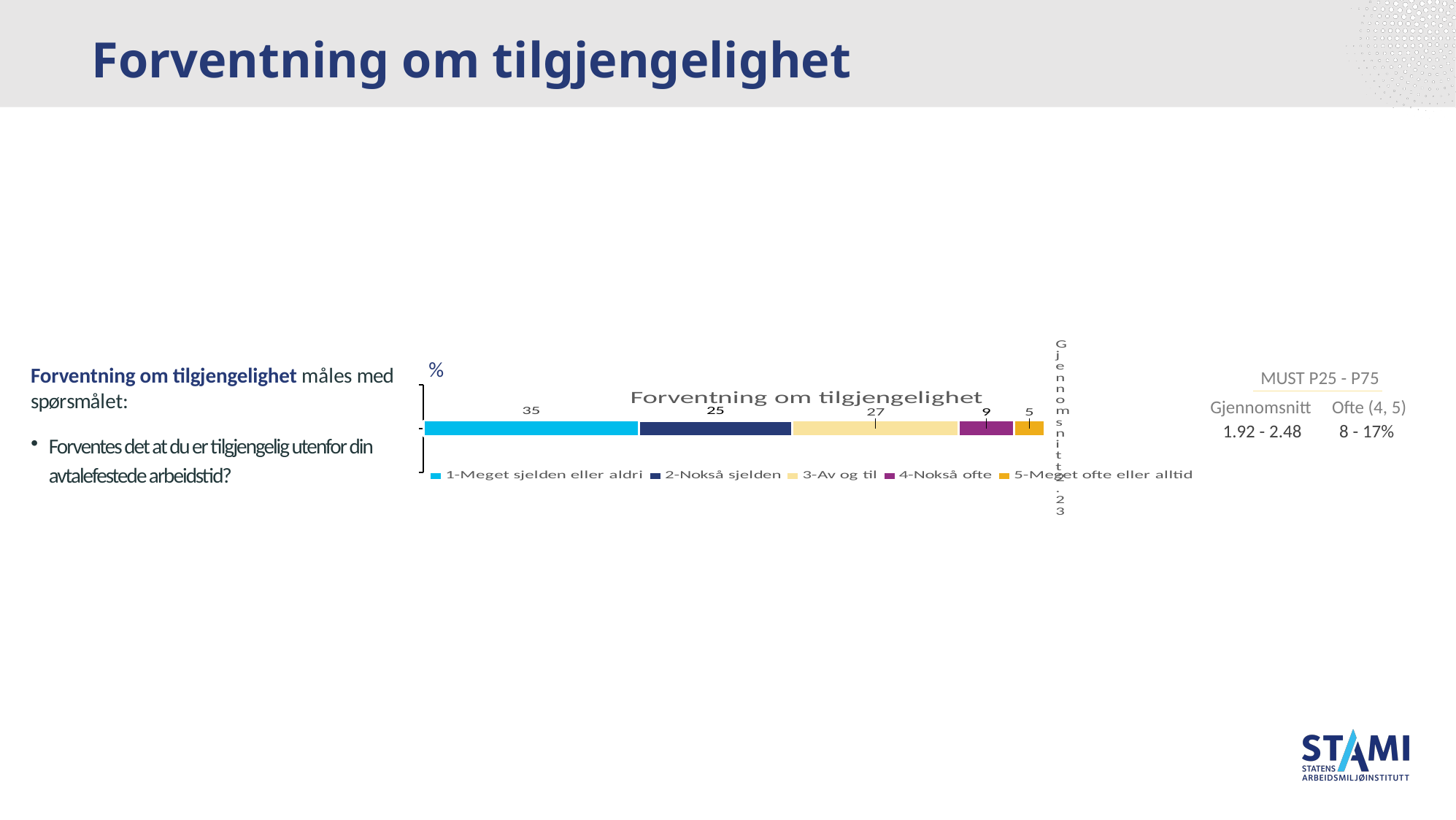
What type of chart is shown on the slide? bar chart Which series has the highest value? 1-Meget sjelden eller aldri What is the value for "2-Nokså sjelden"? 25 Which series has the lowest value? 5-Meget ofte eller alltid What is the value for "4-Nokså ofte"? 9 What is the title of the chart? Forventning om tilgjengelighet What is the value for "3-Av og til"? 27 What is the value for "1-Meget sjelden eller aldri"? 35 Which is larger, the value for "3-Av og til" or the value for "2-Nokså sjelden"? 3-Av og til What is the value for "5-Meget ofte eller alltid"? 5 How many series does the legend list? 5 What is the difference between the values for "1-Meget sjelden eller aldri" and "2-Nokså sjelden"? 10